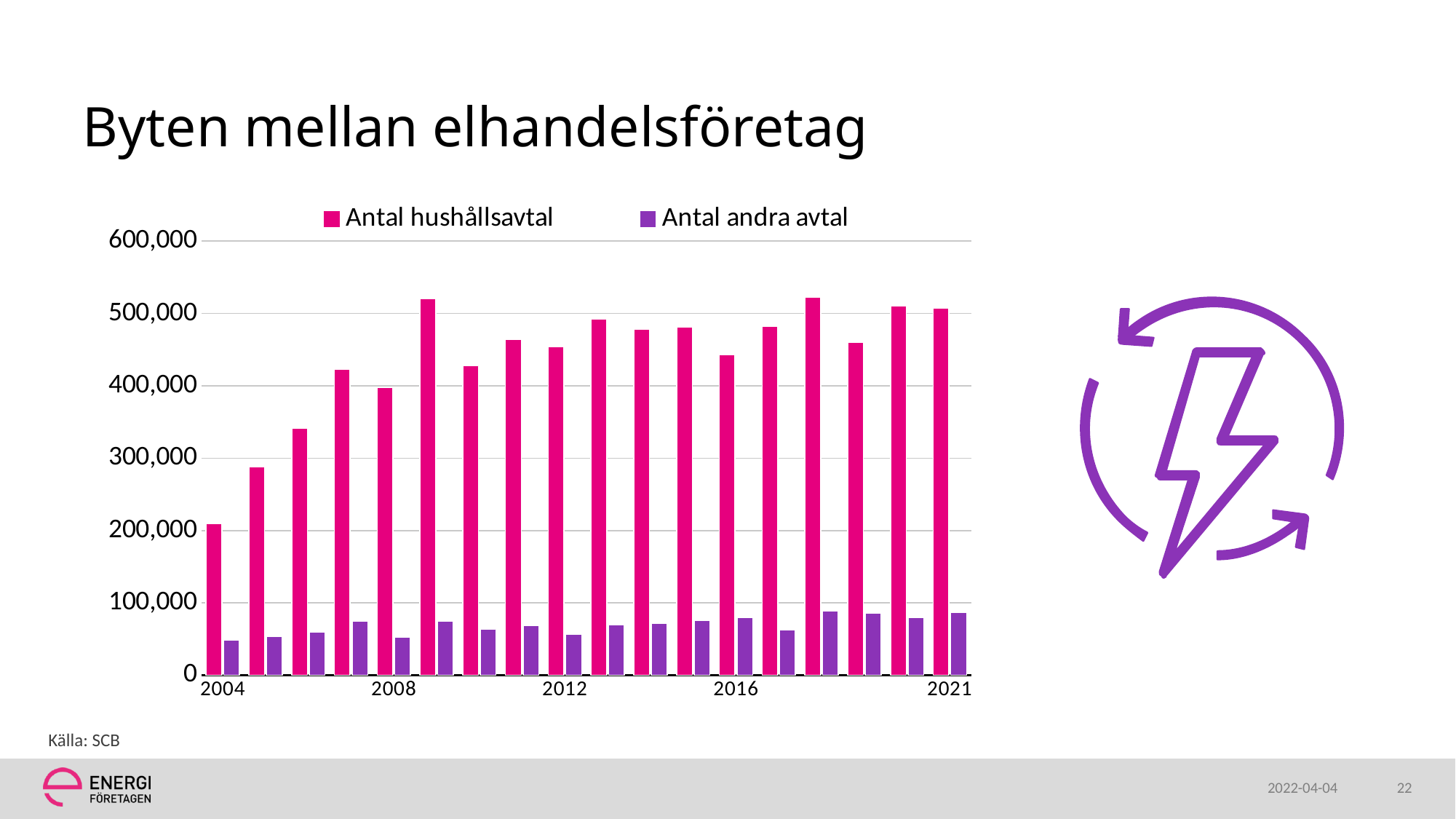
How many years are plotted for each series? 18 What is the title of the chart slide? Byten mellan elhandelsföretag What kind of chart is shown on the slide? Bar chart Is the value for Antal hushållsavtal in 2009 greater or less than 400,000? greater Is the value for Antal hushållsavtal in 2021 greater or less than 400,000? greater What are the two series named in the legend? Antal hushållsavtal and Antal andra avtal Is the value for Antal hushållsavtal in 2004 greater or less than 300,000? less Does Antal hushållsavtal rise or fall from 2004 to 2008? rise Which year has the lowest value for Antal hushållsavtal? 2004 Which is larger in 2021: Antal hushållsavtal or Antal andra avtal? Antal hushållsavtal How many series does the legend list? 2